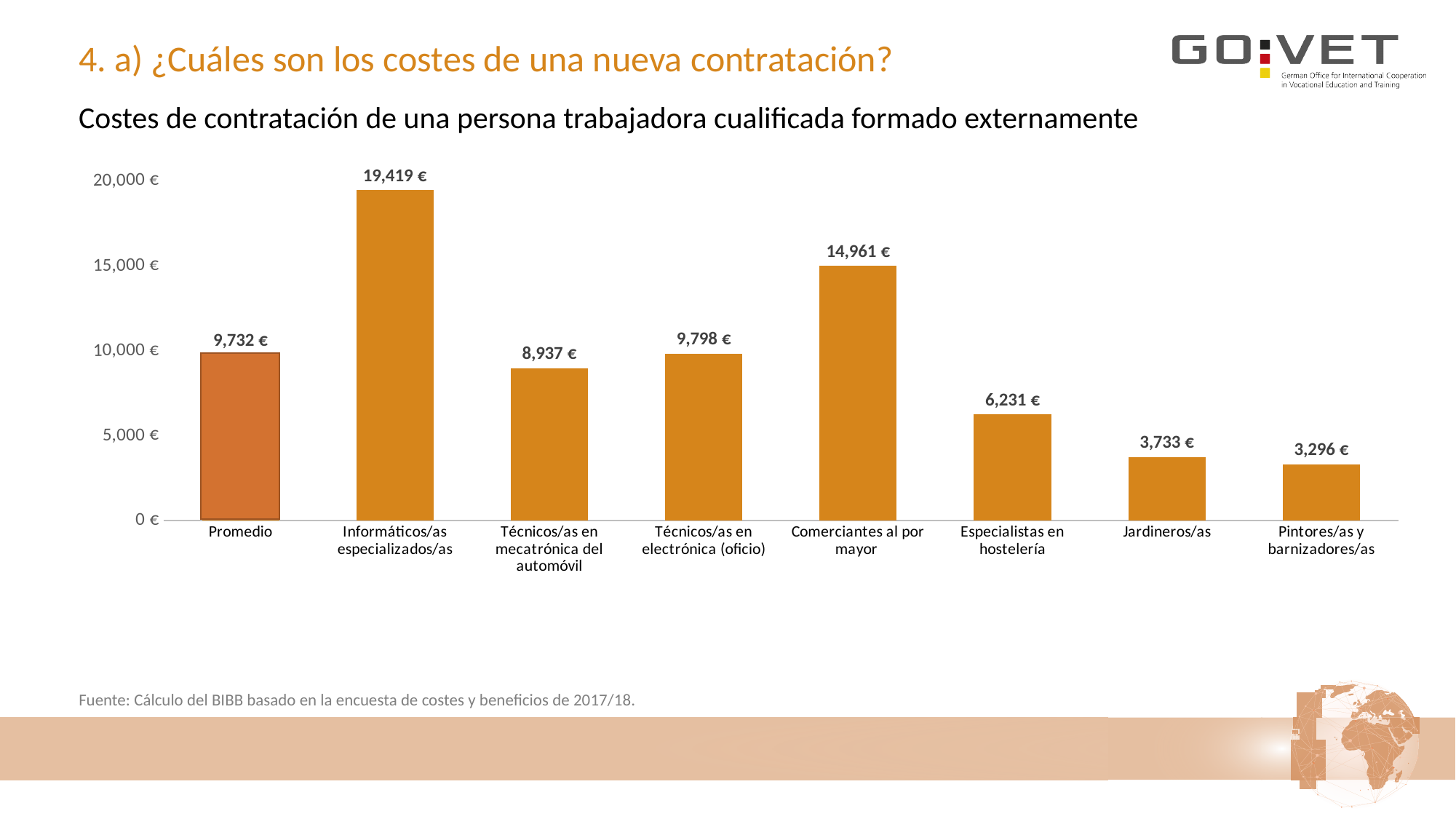
Is the value for Especialistas en hostelería greater or less than 5,000 €? greater What is the value for Comerciantes al por mayor? 14,961 € Which category has the lowest value? Pintores/as y barnizadores/as What is the value for Promedio? 9,732 € Which category has the highest value? Informáticos/as especializados/as What kind of chart is shown on the slide? bar chart Which bar is shown in a different colour from the others? Promedio How many categories are shown on the x axis? 8 What is the difference between the values for Informáticos/as especializados/as and Comerciantes al por mayor? 4,458 € What is the difference between the values for Jardineros/as and Pintores/as y barnizadores/as? 437 € What is the value for Jardineros/as? 3,733 € Which is larger, the value for Técnicos/as en mecatrónica del automóvil or the value for Especialistas en hostelería? Técnicos/as en mecatrónica del automóvil